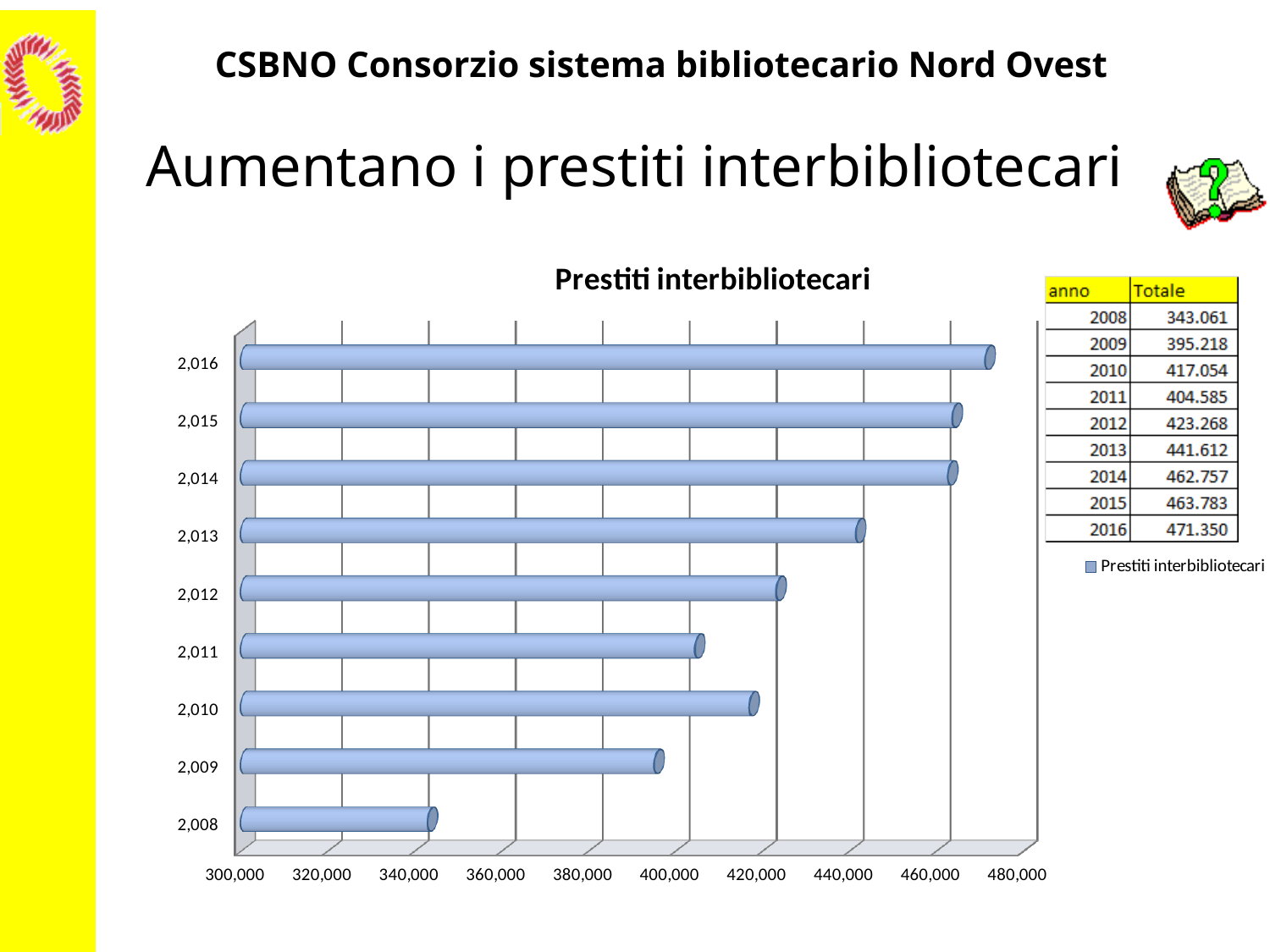
What kind of chart is shown on the slide? bar chart Which year has the lowest value in the chart? 2008 Which is larger, the value for 2010 or the value for 2011? 2010 Is the value for 2013 greater or less than 440,000? greater Using the table values, what is the difference between the Totale for 2016 and the Totale for 2008? 128.289 According to the table, what is the Totale for 2016? 471.350 Which year has the highest value in the chart? 2016 According to the table, what is the Totale for 2012? 423.268 What is the title of the chart? Prestiti interbibliotecari How many series does the legend list? 1 According to the table, what is the Totale for 2008? 343.061 How many years are plotted in the chart? 9